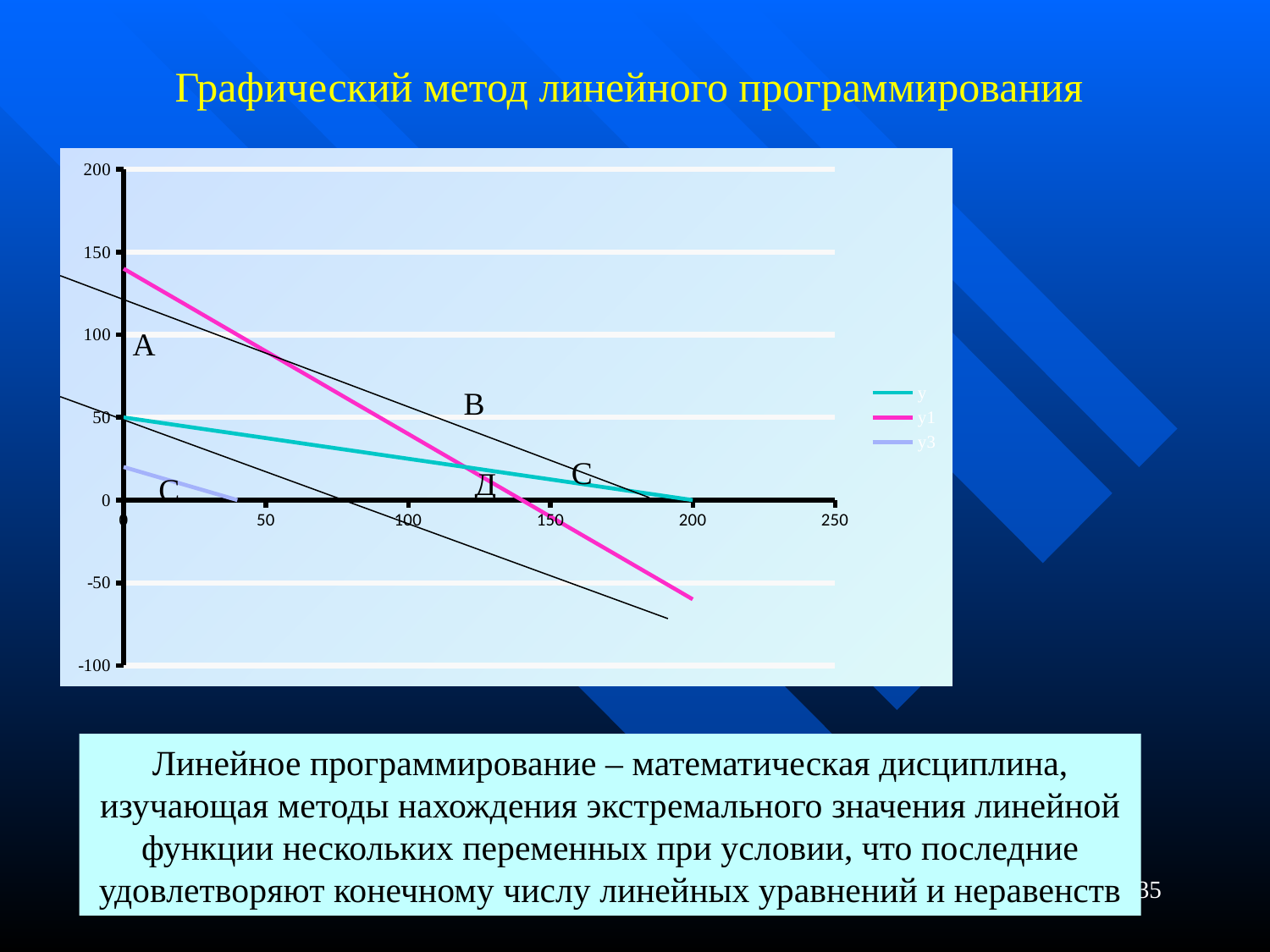
What kind of chart is shown on the slide? line chart Is the value of the series y1 at x = 200 greater or less than 0? less Which series has the lowest value at x = 0? y3 Do the values of the series y rise or fall as x increases? fall At x = 50, which series has the larger value, y or y1? y1 Is the value of the series y3 at x = 0 greater or less than 50? less Which series has the highest value at x = 0? y1 What are the series names listed in the chart legend? y, y1, y3 Which colour is used for the series y1 in the chart? magenta (pink) How many series does the chart legend list? 3 Do the values of the series y1 rise or fall as x increases? fall Is the value of the series y1 at x = 0 greater or less than 100? greater